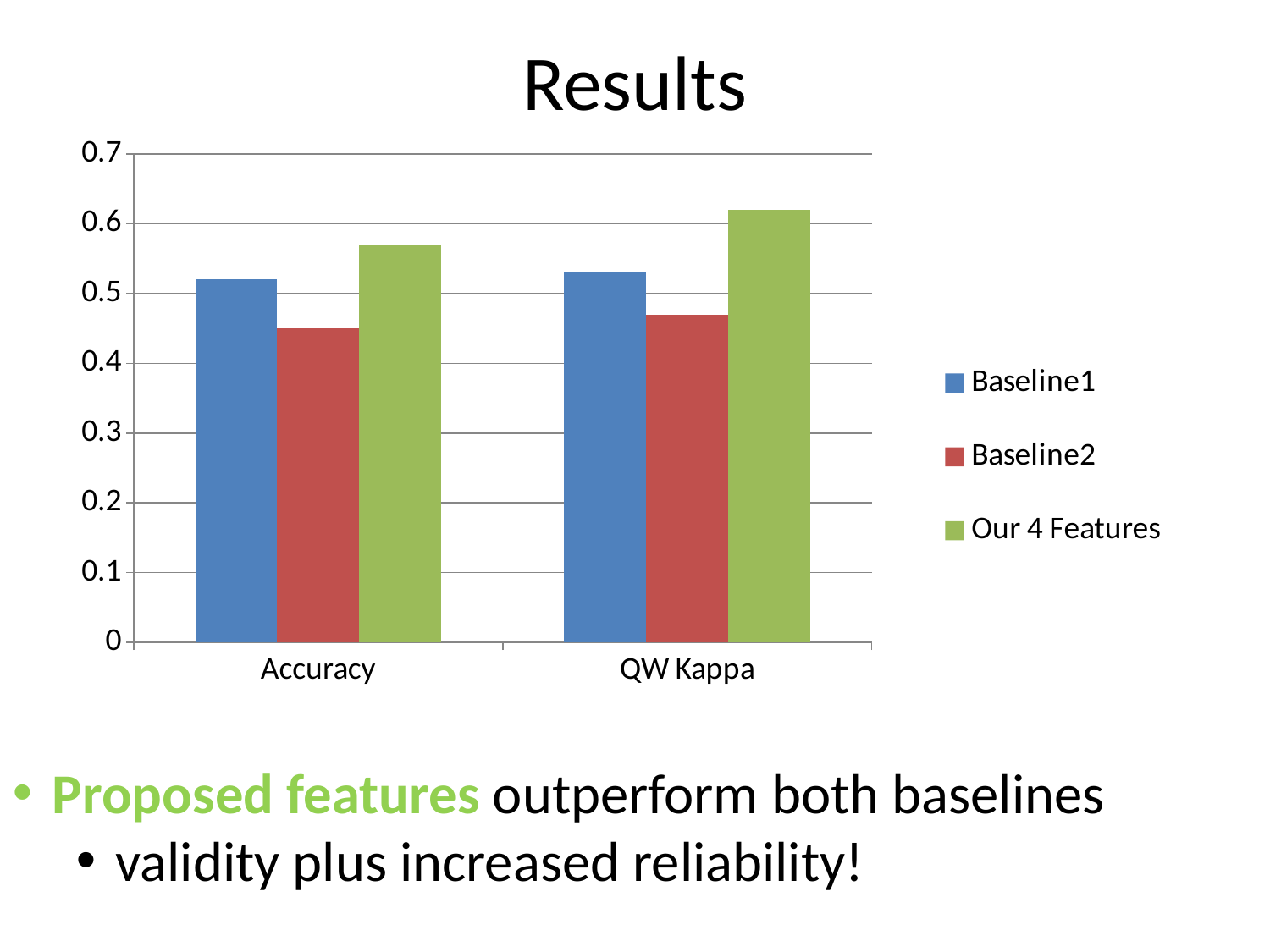
Which series has the lowest value for QW Kappa? Baseline2 How many series does the legend list? 3 Which series has the lowest value for Accuracy? Baseline2 Is the value for Baseline2 on Accuracy greater or less than 0.5? less What kind of chart is shown on the slide? bar chart Which series has the highest value for Accuracy? Our 4 Features For QW Kappa, which is larger: Baseline1 or Baseline2? Baseline1 How many categories are shown on the x axis? 2 Is the value for Baseline1 on QW Kappa greater or less than 0.5? greater Is the value for Our 4 Features on QW Kappa greater or less than 0.6? greater What is the title of the slide containing the chart? Results Which series is shown in green in the legend? Our 4 Features